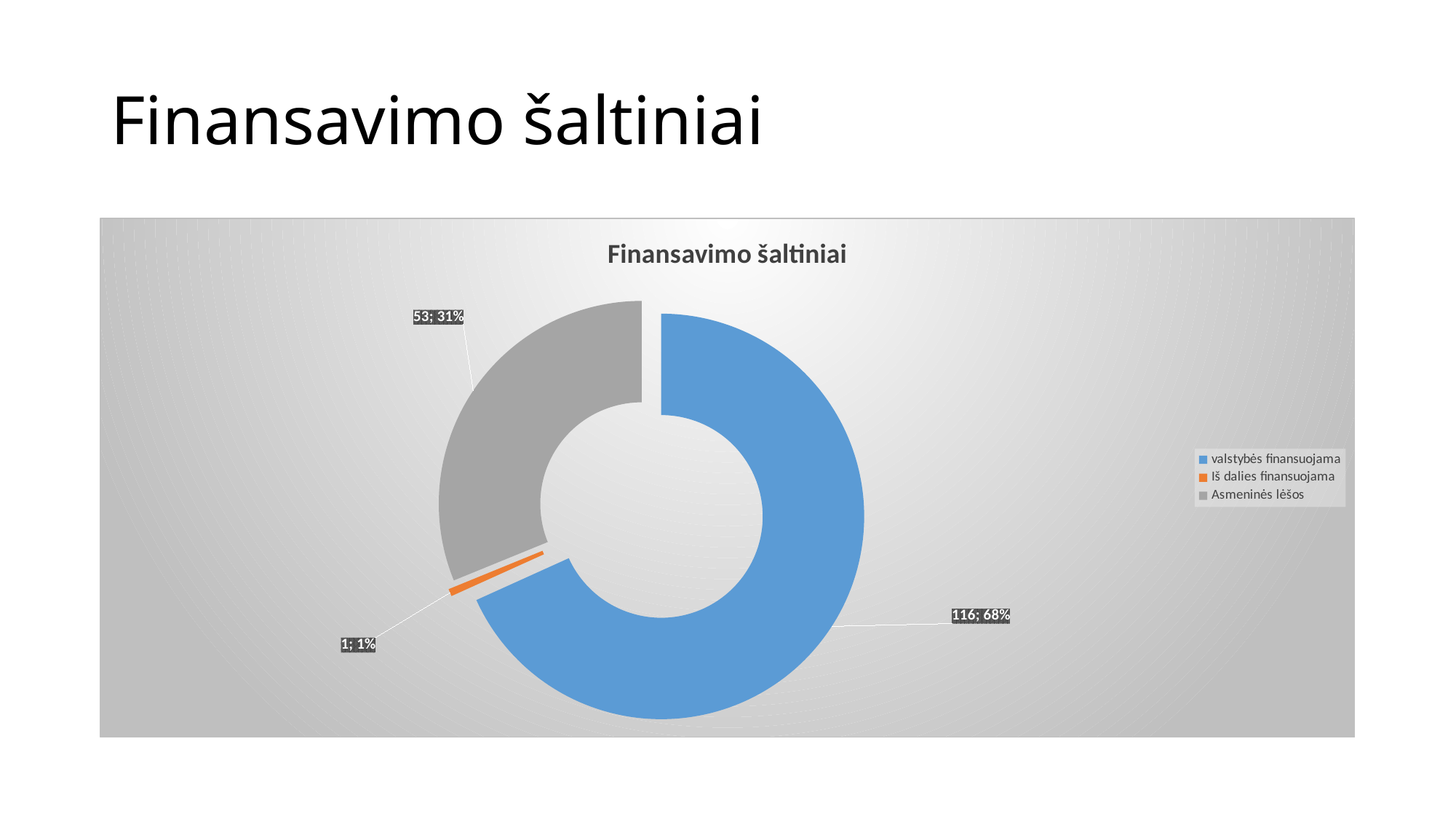
Which category has the highest value? valstybės finansuojama What is the difference between the values for 'valstybės finansuojama' and 'Asmeninės lėšos'? 63 What is the value for 'Iš dalies finansuojama'? 1 What share of the chart does 'valstybės finansuojama' represent? 68% Which is larger, 'Asmeninės lėšos' or 'Iš dalies finansuojama'? Asmeninės lėšos What is the value for 'valstybės finansuojama'? 116 How many categories does the chart show? 3 What is the value for 'Asmeninės lėšos'? 53 What is the title of the chart? Finansavimo šaltiniai Which category has the lowest value? Iš dalies finansuojama What kind of chart is shown? Doughnut chart What share of the chart does 'Asmeninės lėšos' represent? 31%